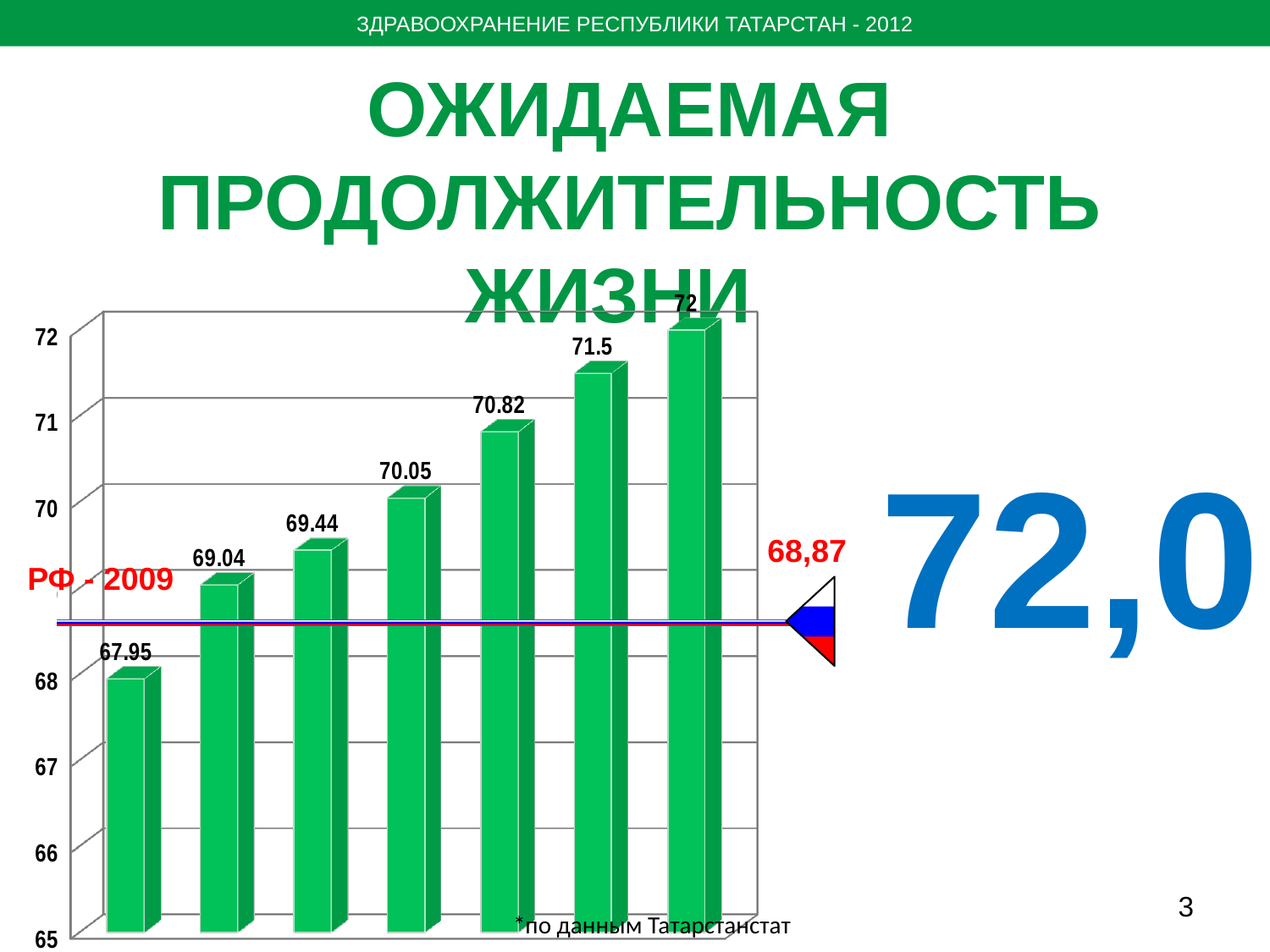
How many bars are plotted in the chart? 7 What is the value labelled on the last (rightmost) bar? 72 What is the difference between the last bar (72) and the first bar (67.95)? 4.05 Do the bar values rise or fall from left to right? rise What kind of chart is shown on the slide? bar chart What is the value labelled on the fourth bar from the left? 70.05 Is the value of the second bar from the left (69.04) greater or less than 69? greater Which bar has the highest value? the last (rightmost) bar, 72 What is the value labelled on the sixth bar from the left? 71.5 What value is marked for the horizontal reference line labelled 'РФ - 2009'? 68,87 Which bar has the lowest value? the first (leftmost) bar, 67.95 What is the value labelled on the first (leftmost) bar? 67.95